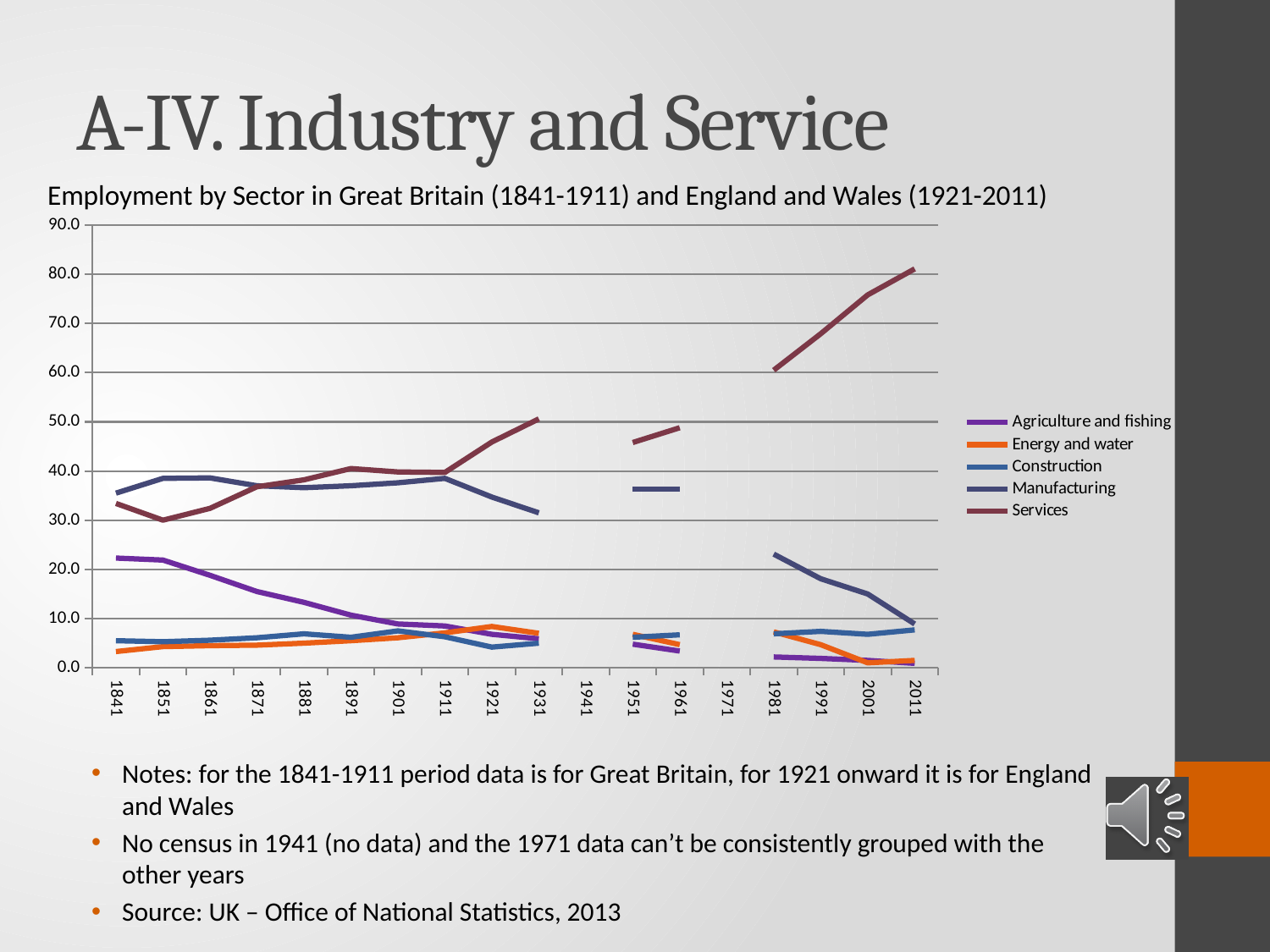
Is the value for Agriculture and fishing in 1841 greater or less than 20? greater How many years are marked along the x axis of the chart? 18 Does the Services series rise or fall from 1981 to 2011? rise Is the value for Services in 1851 greater or less than 40? less What is the title of the chart? Employment by Sector in Great Britain (1841-1911) and England and Wales (1921-2011) Does the Agriculture and fishing series rise or fall from 1841 to 1931? fall Is the value for Manufacturing in 1981 greater or less than 20? greater What kind of chart is shown on the slide? line chart How many series does the chart's legend list? 5 Which series is plotted in orange in the chart? Energy and water Which series has the highest value in 2011? Services